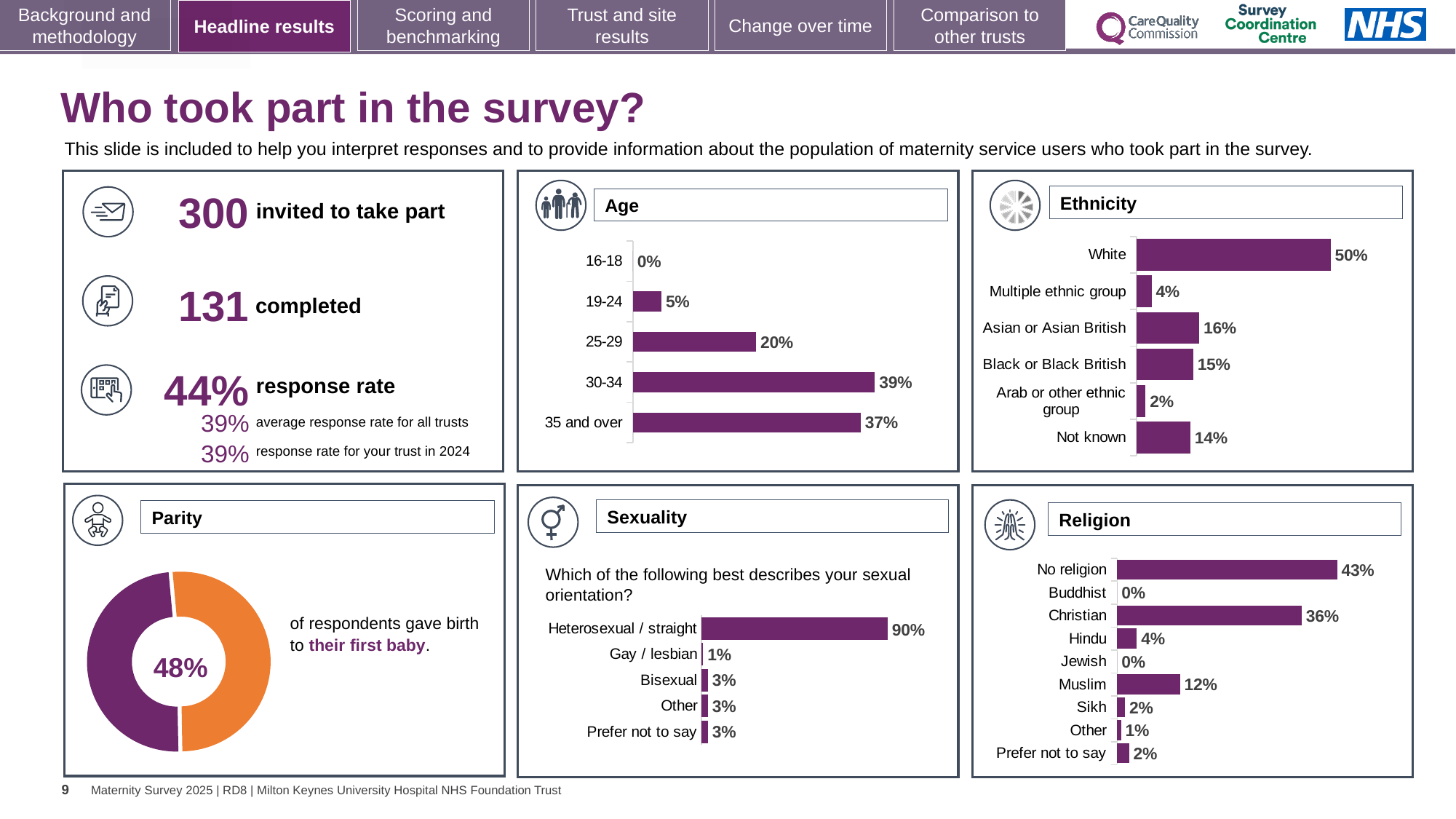
In the Religion chart, which is larger, the percentage for Christian or for No religion? No religion In the Age chart, which age group has the highest percentage? 30-34 In the Ethnicity chart, what percentage of respondents were White? 50% In the Ethnicity chart, how many ethnicity categories are shown? 6 In the Ethnicity chart, what is the difference between the percentages for Asian or Asian British and Black or Black British? 1% In the Religion chart, what percentage of respondents were Muslim? 12% In the Parity chart, what percentage of respondents gave birth to their first baby? 48% In the Religion chart, which religion category has the highest percentage? No religion In the Sexuality chart, how many response categories are shown? 5 What kind of chart is the Parity chart? Doughnut chart In the Sexuality chart, what percentage of respondents answered Heterosexual / straight? 90% In the Age chart, what percentage of respondents were aged 30-34? 39%